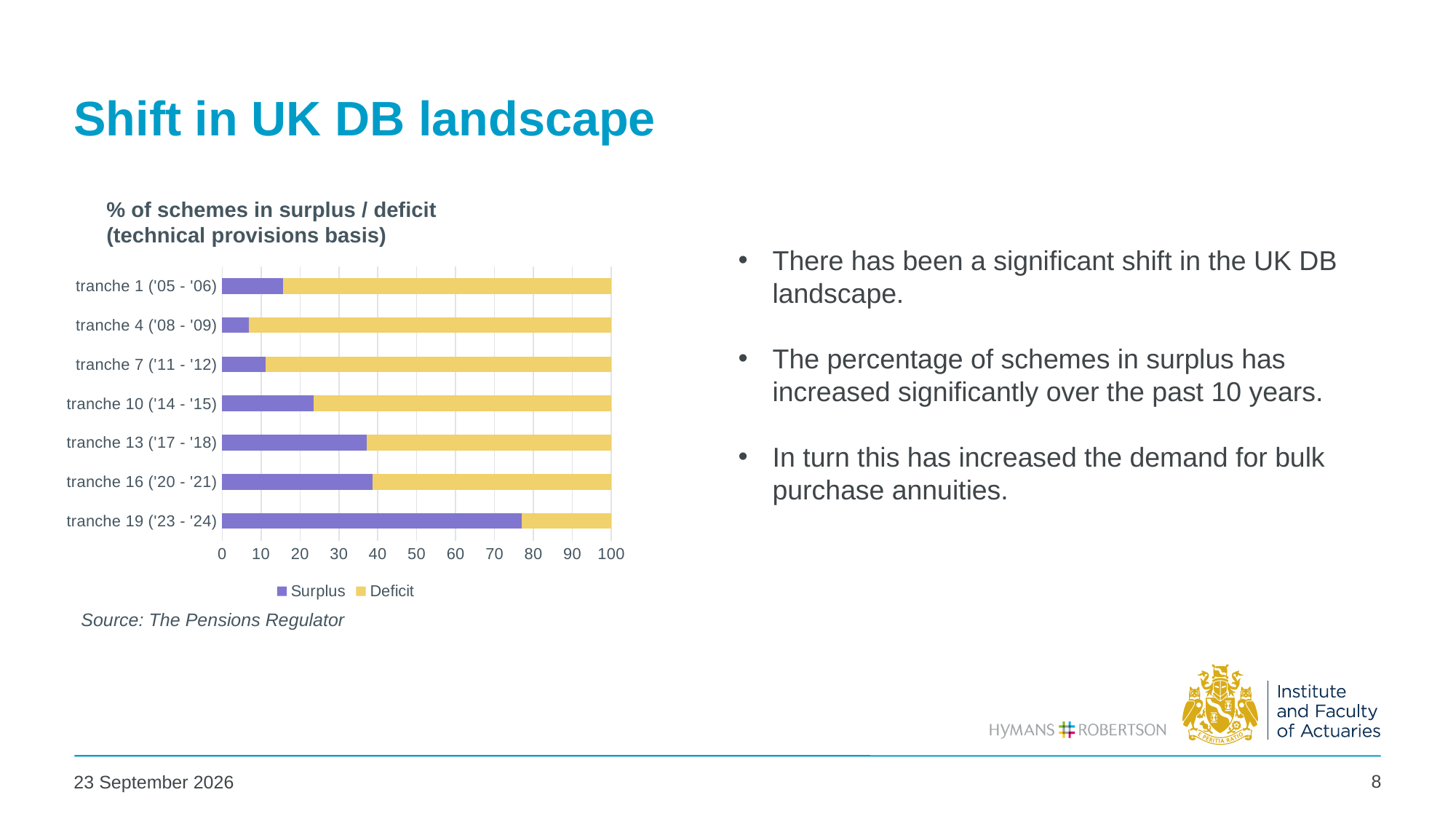
Is the Surplus value for tranche 19 ('23 - '24) greater or less than 70? greater Is the Surplus value for tranche 13 ('17 - '18) greater or less than 30? greater Which has a larger Surplus share: tranche 1 ('05 - '06) or tranche 10 ('14 - '15)? tranche 10 ('14 - '15) What is the total of the stacked bar for tranche 19 ('23 - '24)? 100 Is the Surplus value for tranche 4 ('08 - '09) greater or less than 10? less Does the Surplus share generally rise or fall from tranche 1 ('05 - '06) to tranche 19 ('23 - '24)? Rise What kind of chart is shown on the slide? Stacked bar chart What are the two series named in the chart legend? Surplus and Deficit Which tranche has the lowest percentage of schemes in surplus? tranche 4 ('08 - '09) Which tranche has the highest percentage of schemes in surplus? tranche 19 ('23 - '24) How many series does the chart legend list? 2 How many tranches (categories) are plotted in the chart? 7